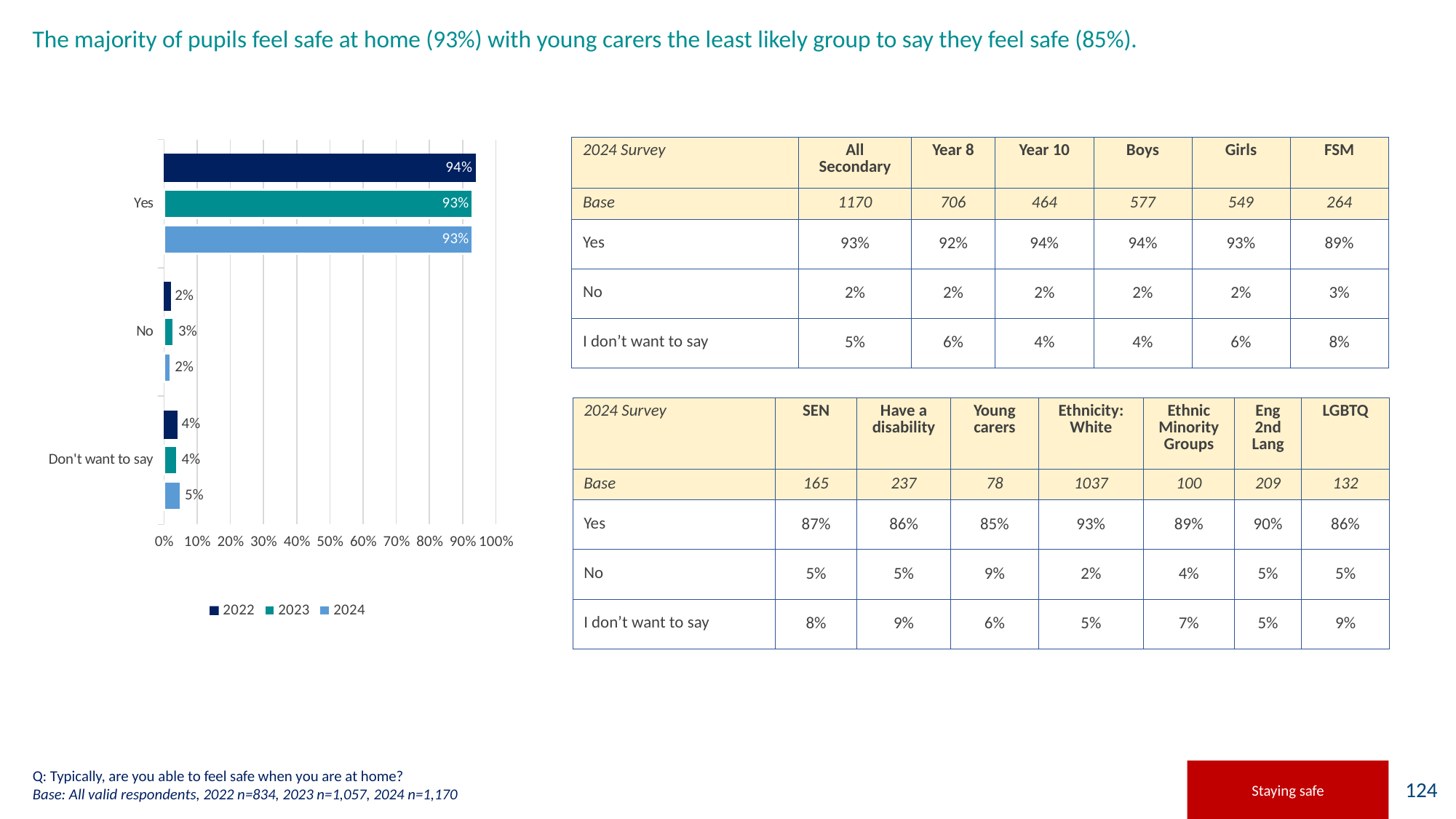
What is the 2024 value for 'Don't want to say' in the chart? 5% What is the difference between the 2022 and 2024 values for 'Yes' in the chart? 1% How many response categories are shown on the chart? 3 What kind of chart is shown on the slide? bar chart Which response category has the highest value for 2024 in the chart? Yes How many series does the chart legend list? 3 In the chart, is the 2023 value for 'Don't want to say' larger or smaller than the 2024 value for 'Don't want to say'? smaller Which response category has the lowest value for 2022 in the chart? No Which year is shown in the darkest blue colour in the chart legend? 2022 What is the 2022 value for 'Yes' in the chart? 94% What is the 2024 value for 'Yes' in the chart? 93% What is the 2023 value for 'No' in the chart? 3%